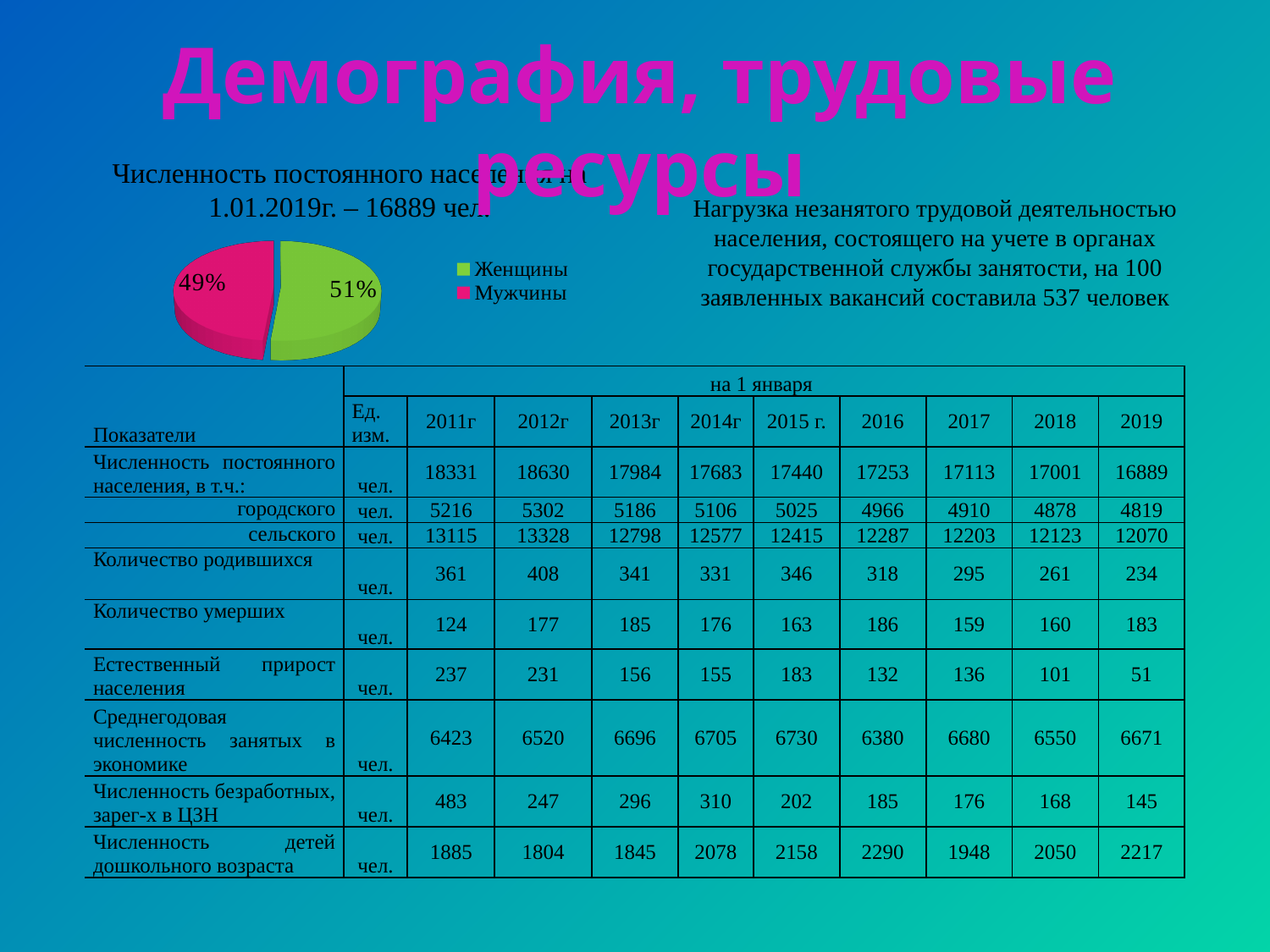
How many entries does the legend of the pie chart list? 2 Which slice of the pie chart is the largest? Женщины What colour is the Мужчины slice in the pie chart? pink In the pie chart, what share is shown for Женщины? 51% What colour is the Женщины slice in the pie chart? green In the pie chart, what share is shown for Мужчины? 49% Which slice of the pie chart is the smallest? Мужчины What kind of chart is shown on the slide? pie chart How many slices does the pie chart have? 2 In the pie chart, which is larger: the share for Женщины or the share for Мужчины? Женщины By how many percentage points does the Женщины slice exceed the Мужчины slice in the pie chart? 2